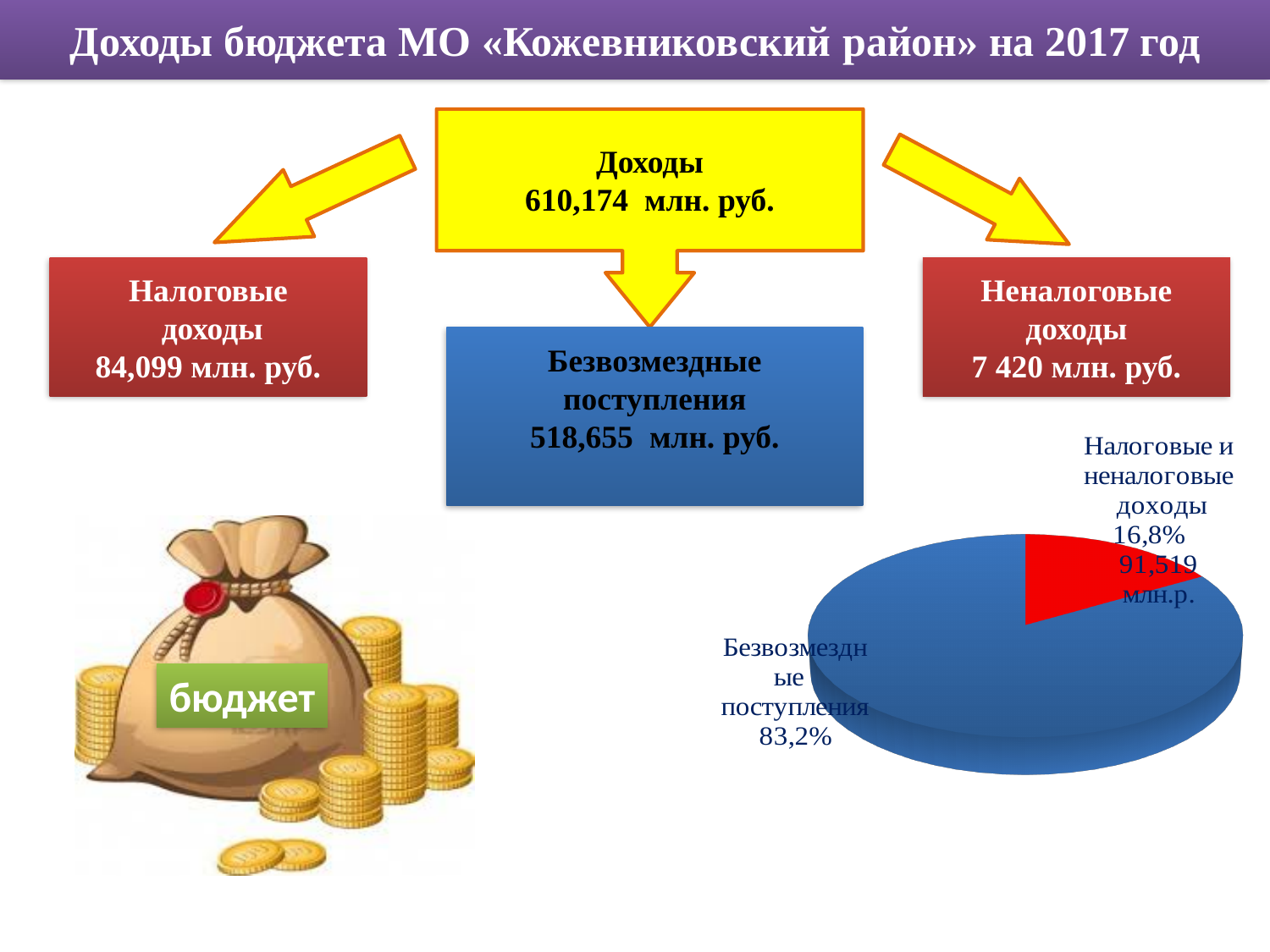
What value in млн.р. is printed for the "Налоговые и неналоговые доходы" slice? 91,519 млн.р. Which is larger: the share of "Безвозмездные поступления" or the share of "Налоговые и неналоговые доходы"? Безвозмездные поступления Which slice of the pie chart is the largest? Безвозмездные поступления What kind of chart is shown on the slide? pie chart How many slices does the pie chart have? 2 What share of the pie does "Налоговые и неналоговые доходы" have? 16,8% Which slice of the pie chart is the smallest? Налоговые и неналоговые доходы What share of the pie does "Безвозмездные поступления" have? 83,2% What is the difference in percentage points between the "Безвозмездные поступления" and "Налоговые и неналоговые доходы" slices? 66,4 What colour is the "Безвозмездные поступления" slice in the pie chart? blue What colour is the "Налоговые и неналоговые доходы" slice in the pie chart? red